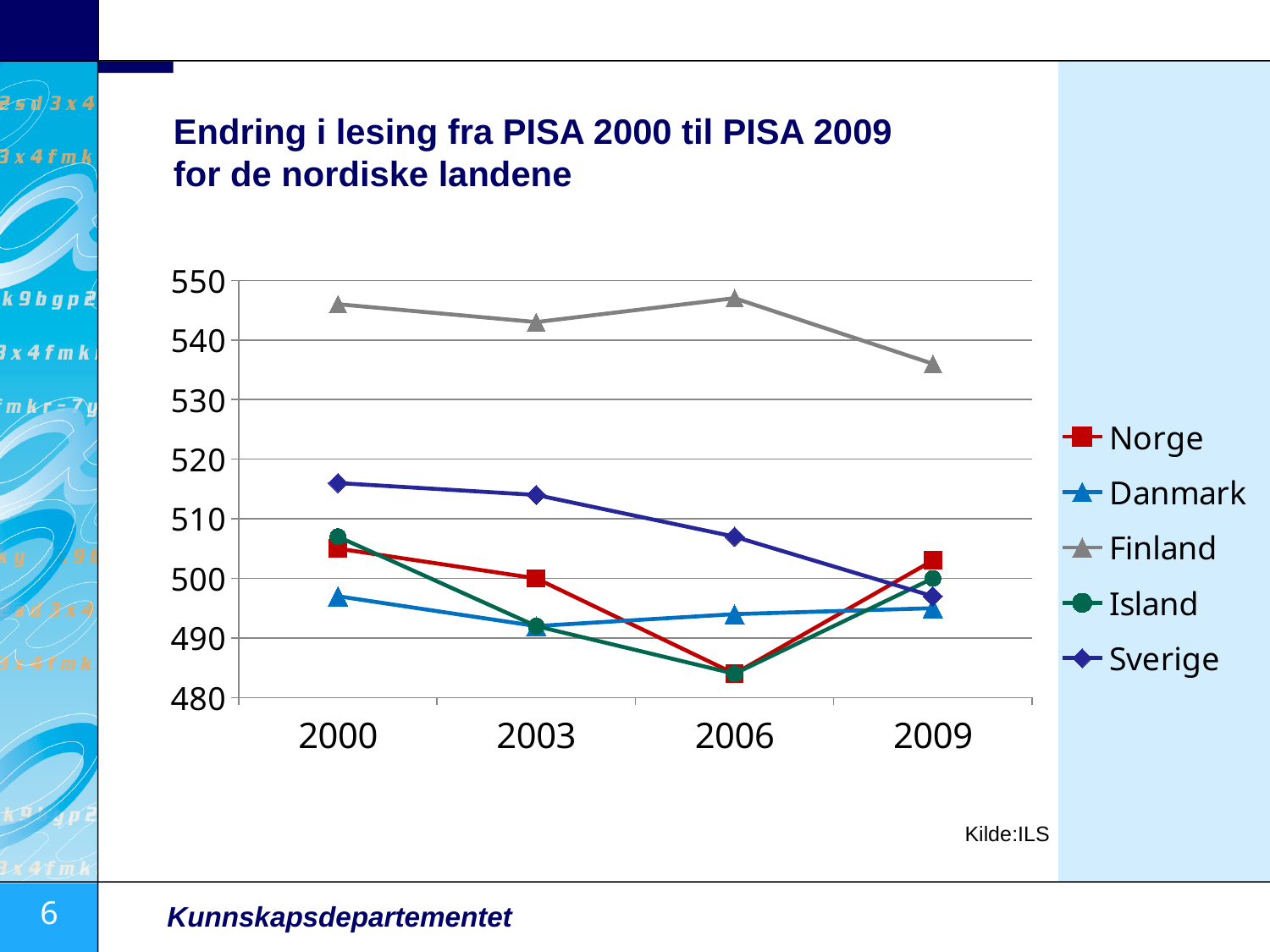
Which is larger in 2000, the value for Sverige or the value for Norge? Sverige Is the value for Finland in 2009 greater or less than 530? greater Do the values for Sverige rise or fall from 2000 to 2009? fall Which country has the lowest value in 2000? Danmark Is the value for Danmark in 2003 greater or less than 500? less Which country has the highest value in 2000? Finland Is the value for Norge in 2006 greater or less than 490? less Which country has the highest value in 2009? Finland How many series does the legend list? 5 What kind of chart is shown on the slide? line chart How many years are plotted along the x axis? 4